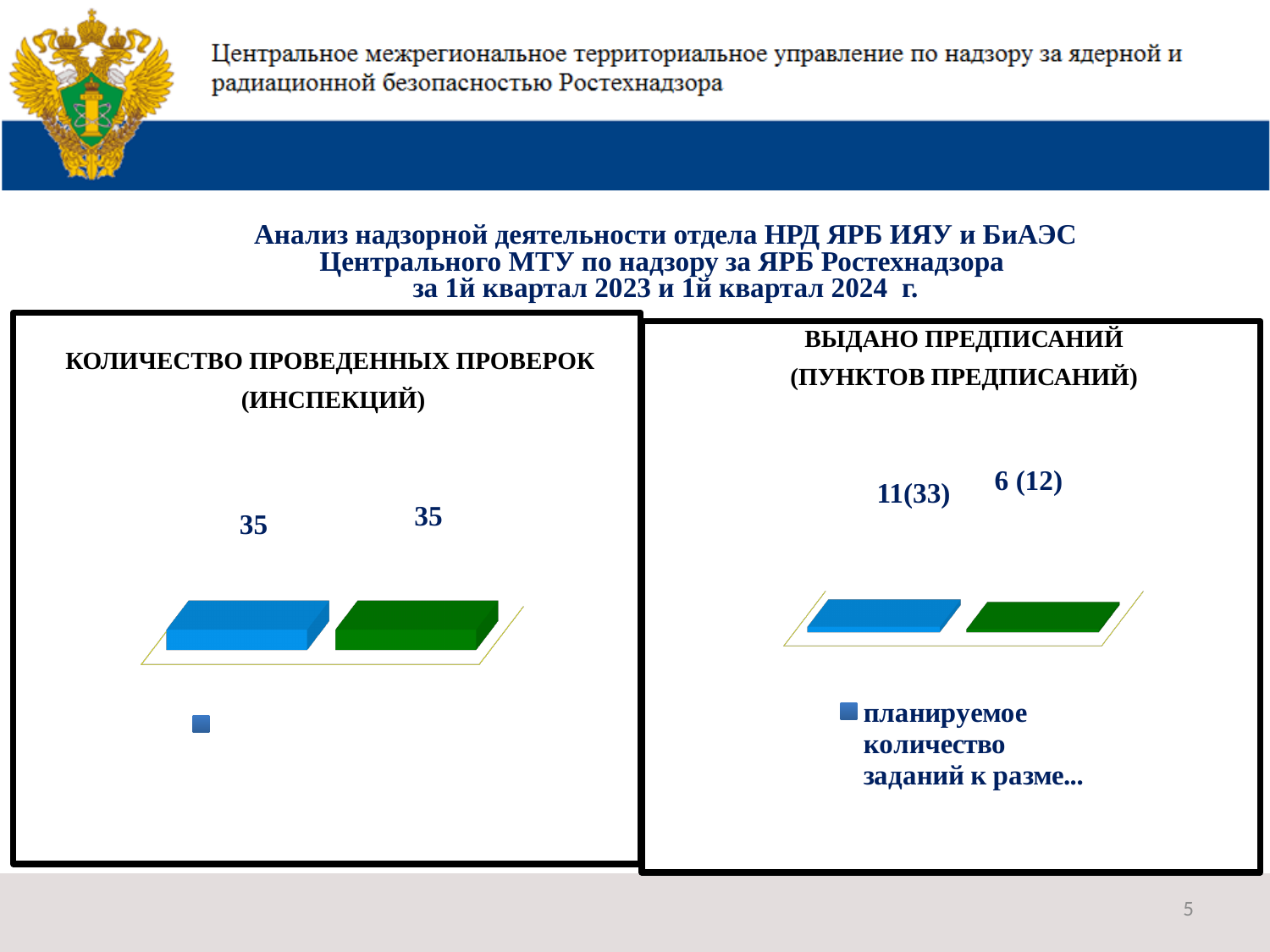
How many bars are plotted in the left chart «КОЛИЧЕСТВО ПРОВЕДЕННЫХ ПРОВЕРОК (ИНСПЕКЦИЙ)»? 2 In the right chart «ВЫДАНО ПРЕДПИСАНИЙ (ПУНКТОВ ПРЕДПИСАНИЙ)», what label is shown above the green bar? 6 (12) In the right chart «ВЫДАНО ПРЕДПИСАНИЙ (ПУНКТОВ ПРЕДПИСАНИЙ)», what is the difference between the number of prescription points in parentheses for the blue bar (33) and the green bar (12)? 21 What legend text is shown below the right chart «ВЫДАНО ПРЕДПИСАНИЙ (ПУНКТОВ ПРЕДПИСАНИЙ)»? планируемое количество заданий к разме... In the right chart «ВЫДАНО ПРЕДПИСАНИЙ (ПУНКТОВ ПРЕДПИСАНИЙ)», what label is shown above the blue bar? 11(33) In the left chart «КОЛИЧЕСТВО ПРОВЕДЕННЫХ ПРОВЕРОК (ИНСПЕКЦИЙ)», is the blue bar or the green bar larger? They are equal (both 35) In the right chart «ВЫДАНО ПРЕДПИСАНИЙ (ПУНКТОВ ПРЕДПИСАНИЙ)», what is the difference between the number of prescriptions for the blue bar (11) and the green bar (6)? 5 In the left chart «КОЛИЧЕСТВО ПРОВЕДЕННЫХ ПРОВЕРОК (ИНСПЕКЦИЙ)», what value is labelled on the green bar? 35 What kind of chart is shown in the left panel titled «КОЛИЧЕСТВО ПРОВЕДЕННЫХ ПРОВЕРОК (ИНСПЕКЦИЙ)»? Bar chart In the left chart «КОЛИЧЕСТВО ПРОВЕДЕННЫХ ПРОВЕРОК (ИНСПЕКЦИЙ)», what value is labelled on the blue bar? 35 In the right chart «ВЫДАНО ПРЕДПИСАНИЙ (ПУНКТОВ ПРЕДПИСАНИЙ)», which bar has the higher value? The blue bar (11) How many bars are plotted in the right chart «ВЫДАНО ПРЕДПИСАНИЙ (ПУНКТОВ ПРЕДПИСАНИЙ)»? 2